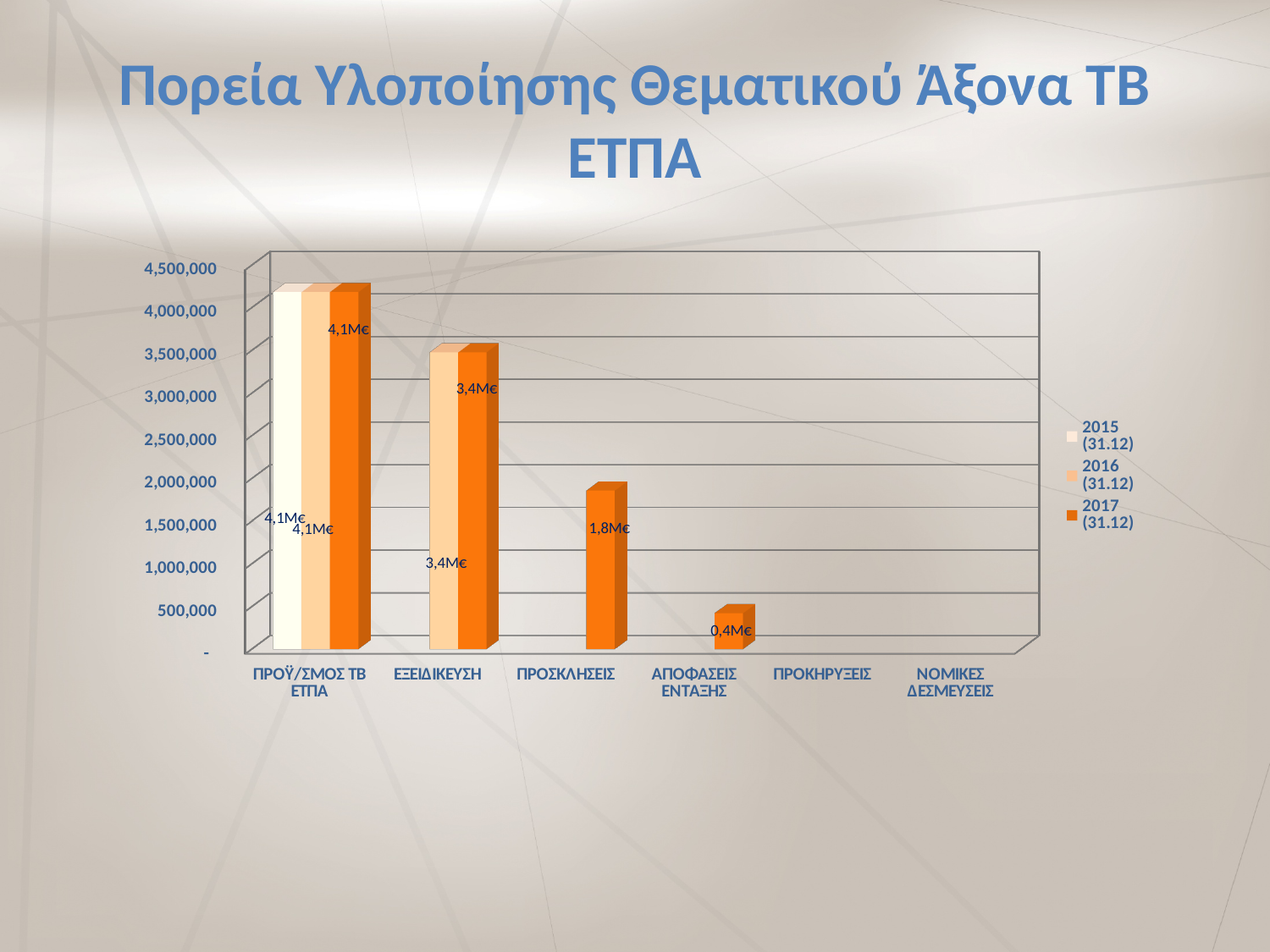
What are the three series listed in the legend? 2015 (31.12), 2016 (31.12), 2017 (31.12) What is the 2015 (31.12) value for ΠΡΟΫ/ΣΜΟΣ ΤΒ ΕΤΠΑ? 4,1M€ What is the 2017 (31.12) value for ΠΡΟΣΚΛΗΣΕΙΣ? 1,8M€ Which of the categories with a plotted 2017 (31.12) bar has the lowest value? ΑΠΟΦΑΣΕΙΣ ΕΝΤΑΞΗΣ How many series does the legend list? 3 Which category has the highest 2017 (31.12) value? ΠΡΟΫ/ΣΜΟΣ ΤΒ ΕΤΠΑ How many categories are shown on the x axis? 6 Is the 2017 (31.12) value for ΠΡΟΣΚΛΗΣΕΙΣ greater or less than 1,500,000? greater What is the 2017 (31.12) value for ΑΠΟΦΑΣΕΙΣ ΕΝΤΑΞΗΣ? 0,4M€ What is the 2016 (31.12) value for ΕΞΕΙΔΙΚΕΥΣΗ? 3,4M€ What kind of chart is shown on the slide? Bar chart Which is larger for 2017 (31.12): ΕΞΕΙΔΙΚΕΥΣΗ or ΠΡΟΣΚΛΗΣΕΙΣ? ΕΞΕΙΔΙΚΕΥΣΗ